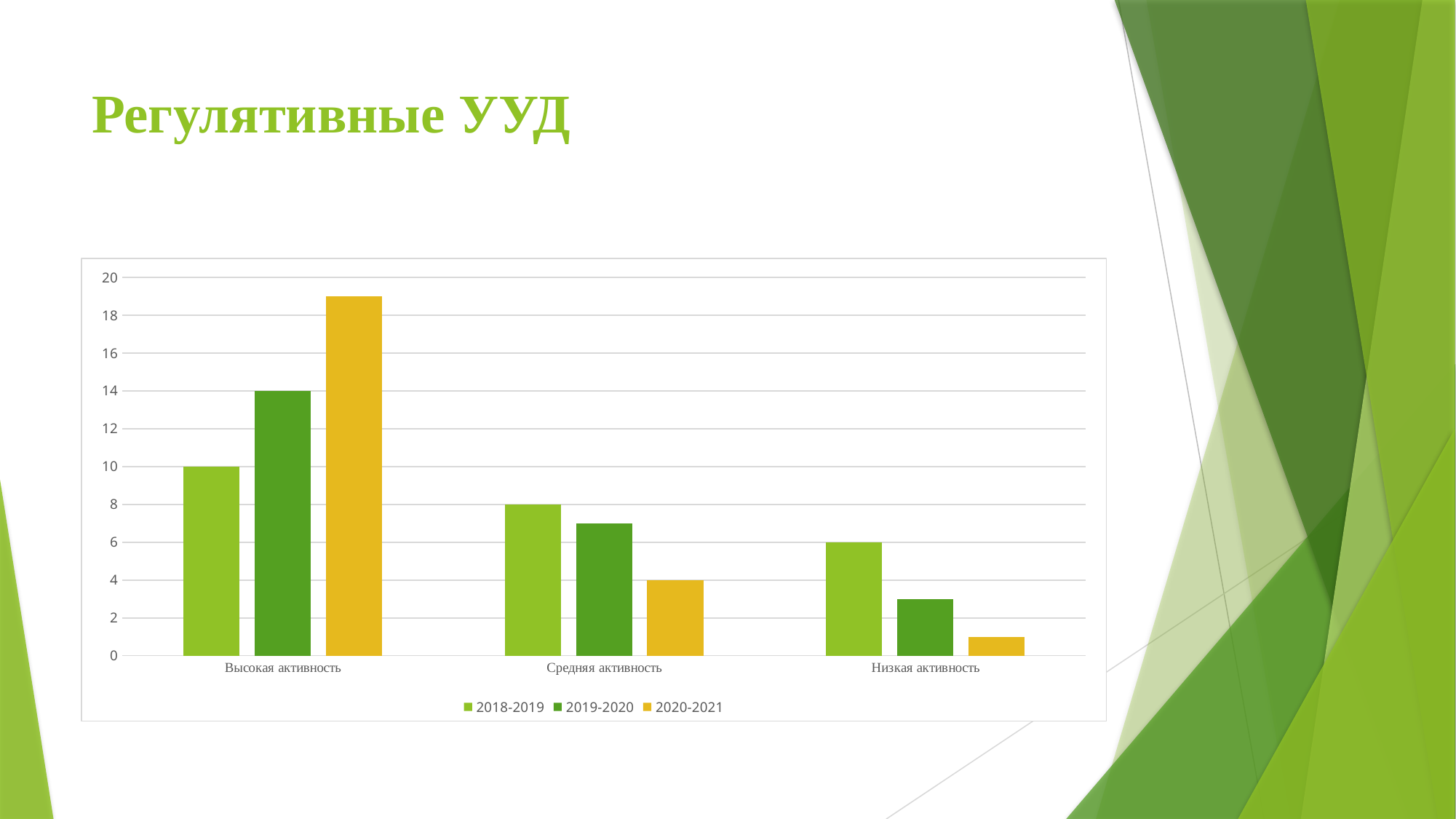
How many categories are shown on the x axis? 3 What is the value for 2019-2020 in the Высокая активность category? 14 Is the value for 2020-2021 in the Высокая активность category greater or less than 18? greater What type of chart is shown on the slide? bar chart What is the value for 2020-2021 in the Средняя активность category? 4 How many series does the legend list? 3 Which series has the highest value in the Высокая активность category? 2020-2021 What is the value for 2018-2019 in the Средняя активность category? 8 Is the value for 2020-2021 in the Низкая активность category greater or less than 2? less What is the difference between the 2019-2020 and 2018-2019 values in the Высокая активность category? 4 What is the value for 2018-2019 in the Высокая активность category? 10 What is the value for 2018-2019 in the Низкая активность category? 6